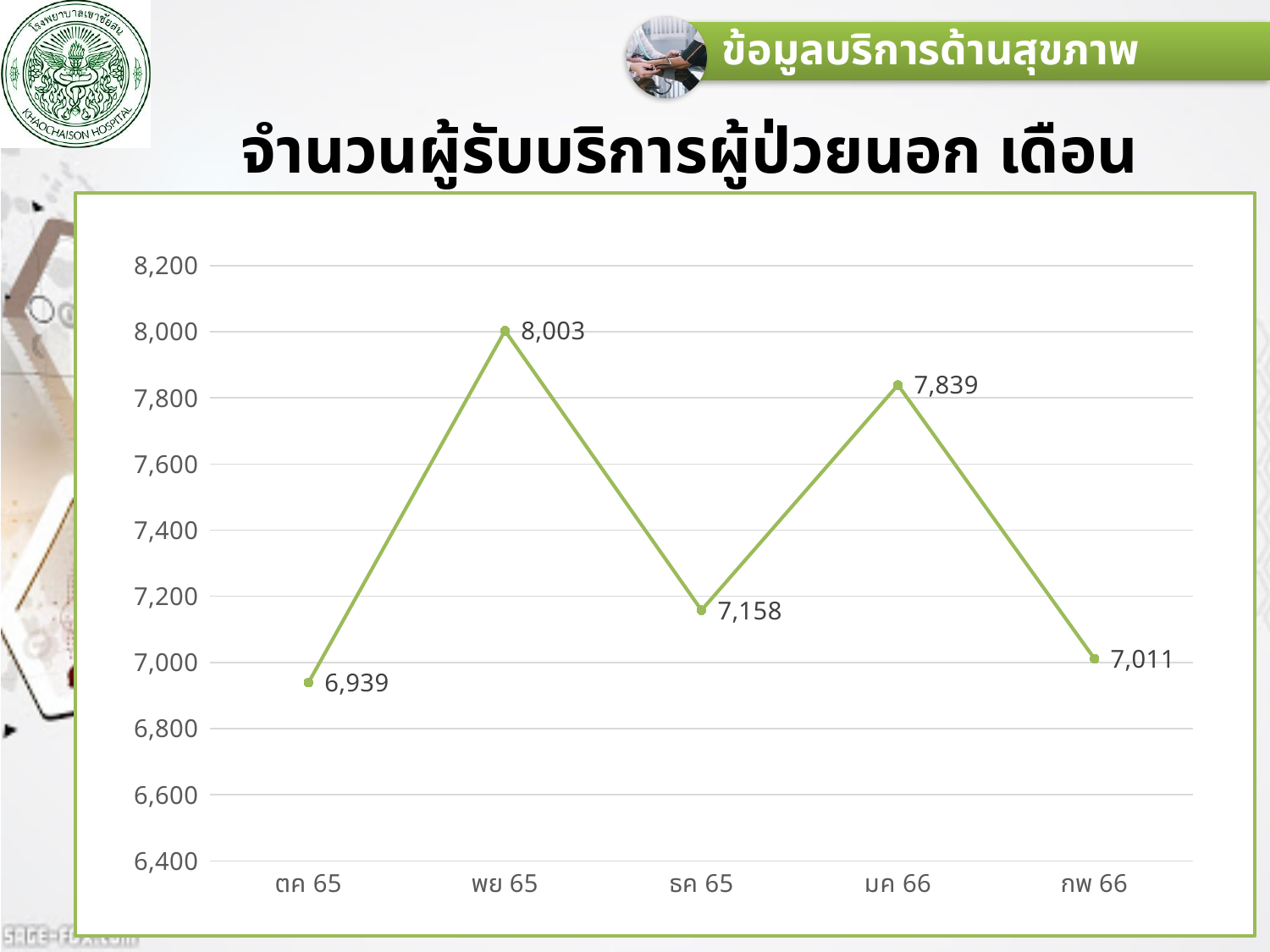
What is the value for กพ 66? 7,011 What is the value for ตค 65? 6,939 Which is larger, the value for ธค 65 or the value for กพ 66? ธค 65 What is the value for มค 66? 7,839 What kind of chart is shown on the slide? line chart Which month has the highest value? พย 65 What is the difference between the values for พย 65 and ธค 65? 845 How many months are plotted on the chart? 5 What is the value for พย 65? 8,003 What is the difference between the values for มค 66 and กพ 66? 828 Which month has the lowest value? ตค 65 Is the value for มค 66 greater or less than 7,600? greater